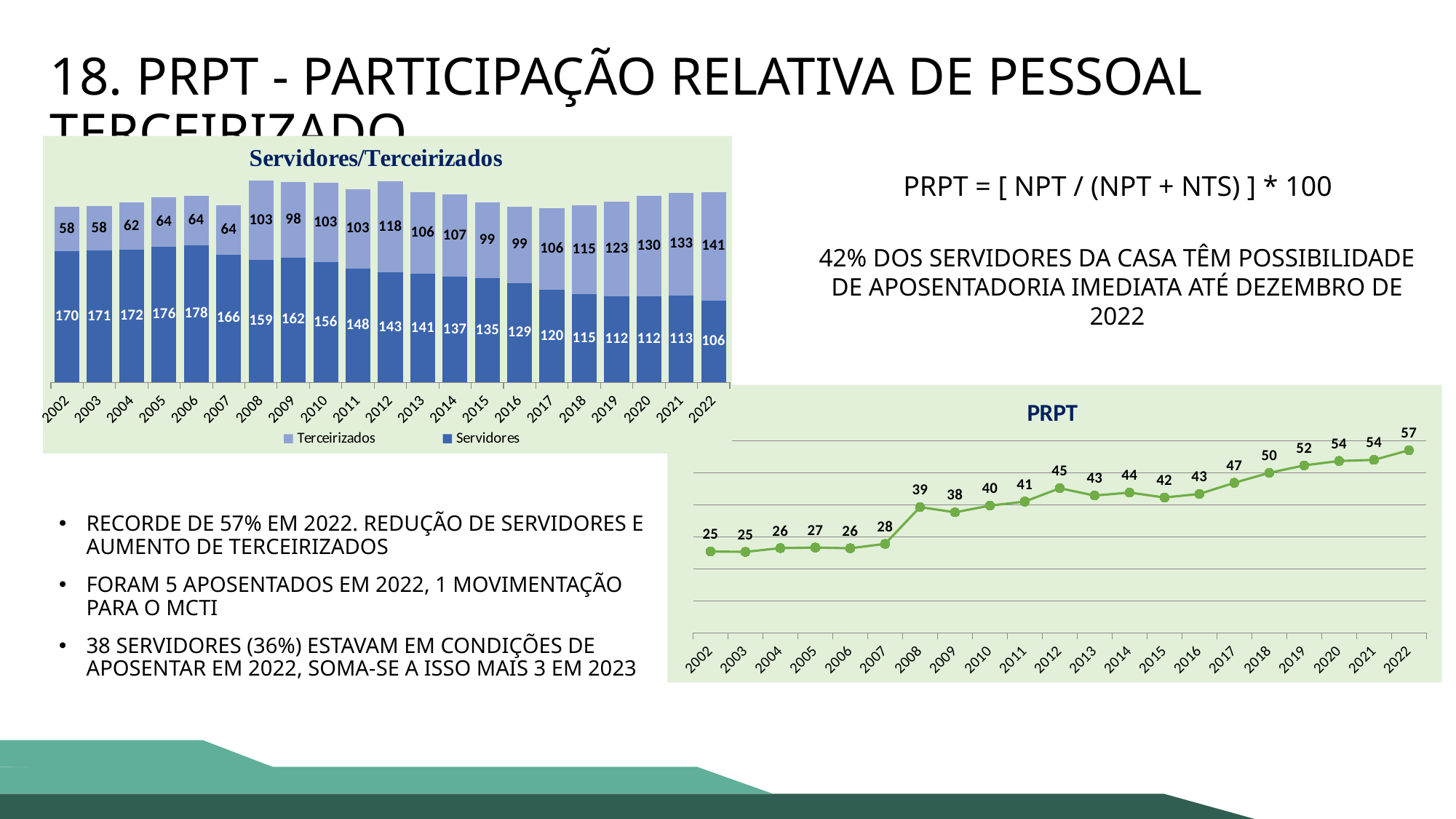
In the Servidores/Terceirizados chart, how many series does the legend list? 2 What kind of chart is the Servidores/Terceirizados chart? Stacked bar chart In the PRPT chart, do the values generally rise or fall from 2002 to 2022? Rise In the PRPT chart, which year has the highest value? 2022 In the Servidores/Terceirizados chart, which year has the highest Terceirizados value? 2022 In the Servidores/Terceirizados chart, which year has the lowest Servidores value? 2022 In the Servidores/Terceirizados chart, what is the Terceirizados value for 2012? 118 In the PRPT chart, what is the value for 2008? 39 In the Servidores/Terceirizados chart, what is the total of the stacked bar for 2022? 247 In the Servidores/Terceirizados chart, what is the Servidores value for 2002? 170 In the Servidores/Terceirizados chart, what is the difference between the Servidores values for 2002 and 2022? 64 In the PRPT chart, how many years are plotted on the x axis? 21